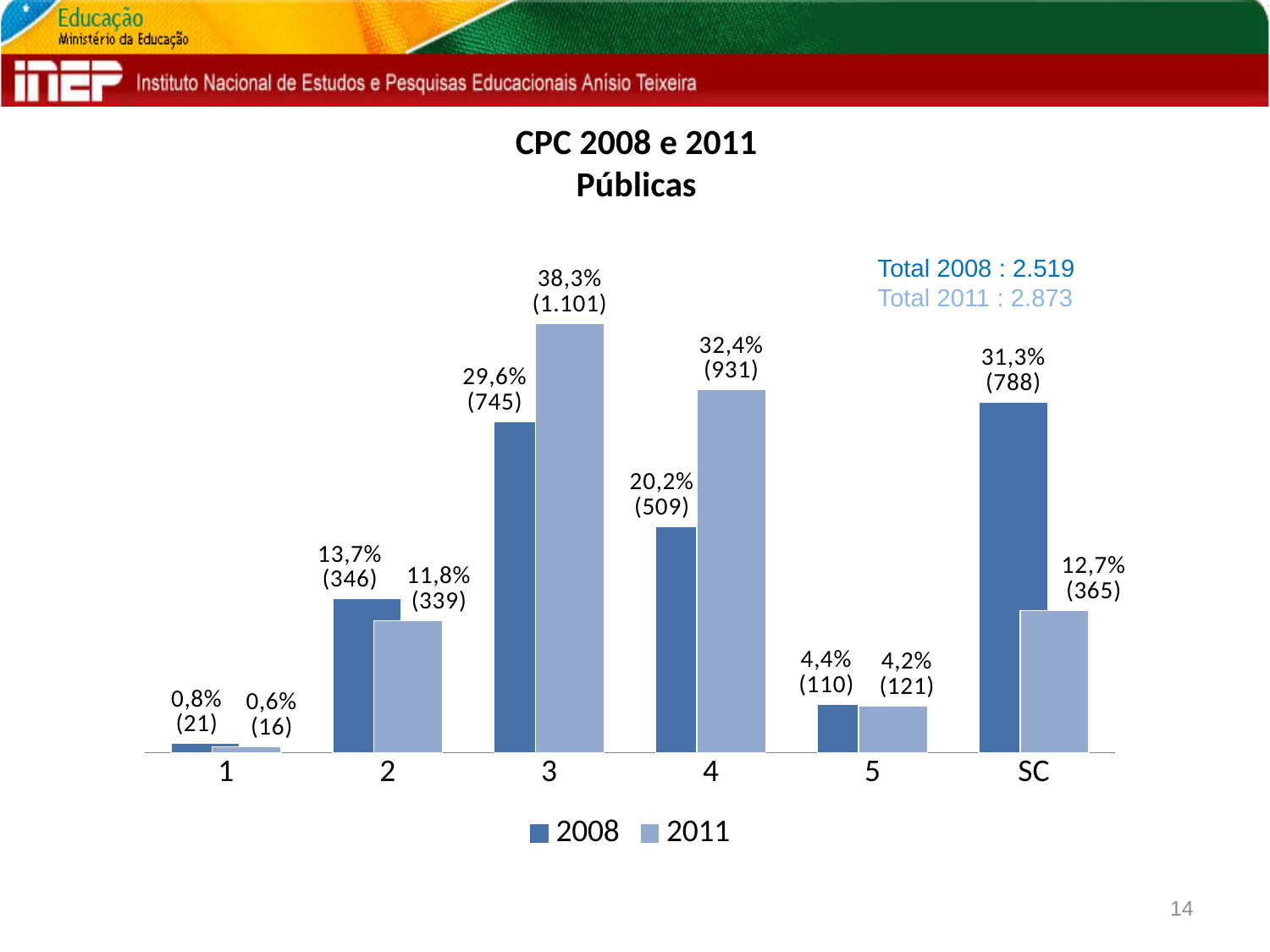
What is the total for 2011 shown on the slide? 2.873 What is the title of the chart? CPC 2008 e 2011 Públicas How many categories are shown on the x axis? 6 Which category has the highest value in the 2011 series? 3 What percentage is shown for category 4 in the 2008 series? 20,2% For category SC, which series has the larger value, 2008 or 2011? 2008 What percentage is shown for category 3 in the 2011 series? 38,3% What is the difference in percentage points between the 2011 and 2008 values for category 4? 12,2 What kind of chart is shown on the slide? Bar chart How many series does the legend list? 2 What count is shown in parentheses for category SC in the 2008 series? 788 Which category has the lowest value in the 2008 series? 1